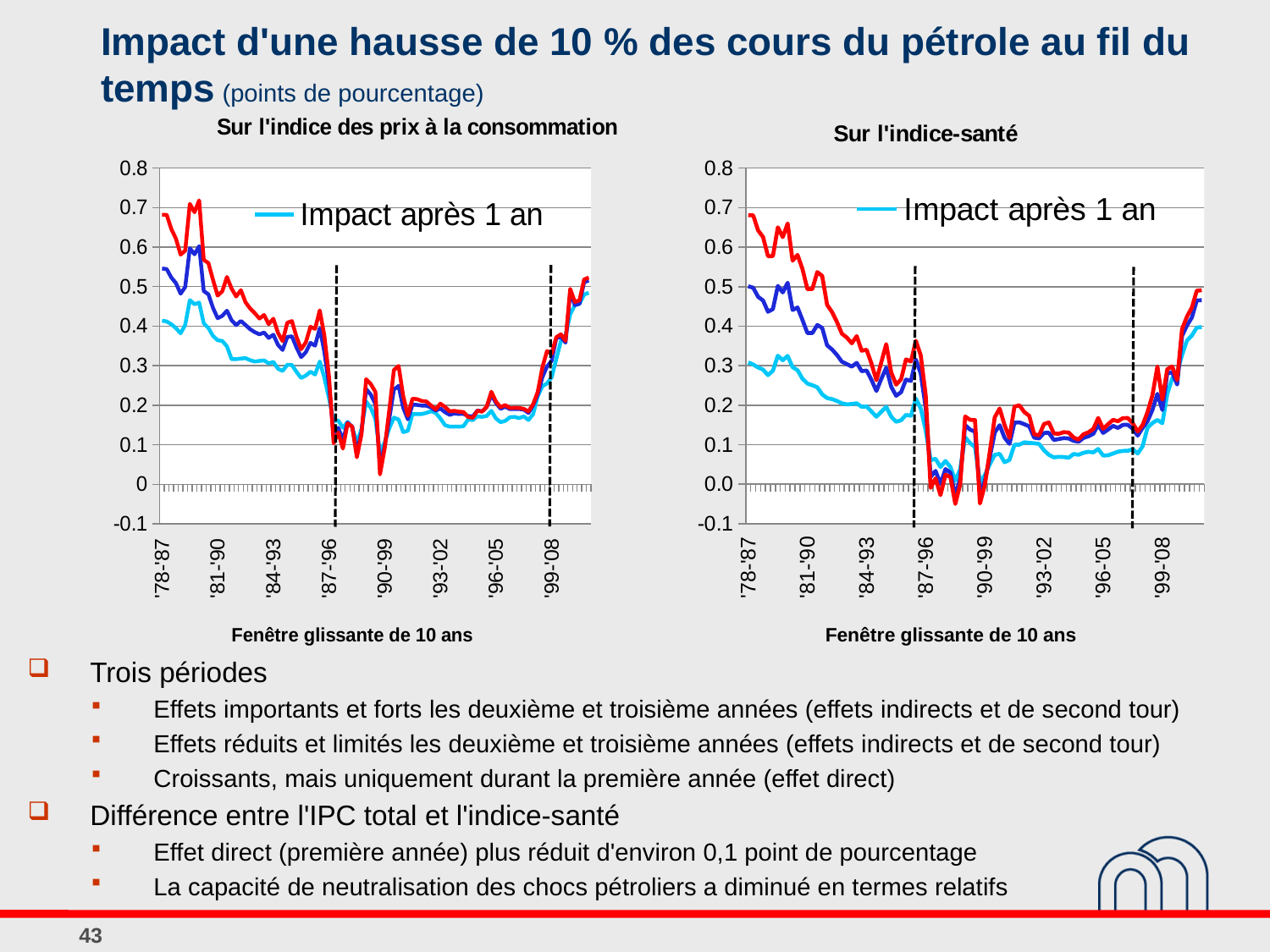
How many x-axis labels are shown on the left chart 'Sur l'indice des prix à la consommation'? 8 What kind of chart is the left chart, 'Sur l'indice des prix à la consommation'? line chart In the left chart 'Sur l'indice des prix à la consommation', is the value of the red line at '78-'87 greater or less than 0.6? greater In the left chart 'Sur l'indice des prix à la consommation', is the value of the light blue 'Impact après 1 an' line at '93-'02 greater or less than 0.3? less What is the x-axis label shown under both charts? Fenêtre glissante de 10 ans In the right chart 'Sur l'indice-santé', is the value of the light blue 'Impact après 1 an' line at '78-'87 greater or less than 0.2? greater What legend entry is shown in the right chart 'Sur l'indice-santé'? Impact après 1 an In the left chart 'Sur l'indice des prix à la consommation', do the values of the red line generally rise or fall between '78-'87 and '90-'99? fall What kind of chart is the right chart, 'Sur l'indice-santé'? line chart In the right chart 'Sur l'indice-santé', do the values of the light blue line generally rise or fall between '96-'05 and the end of the series? rise